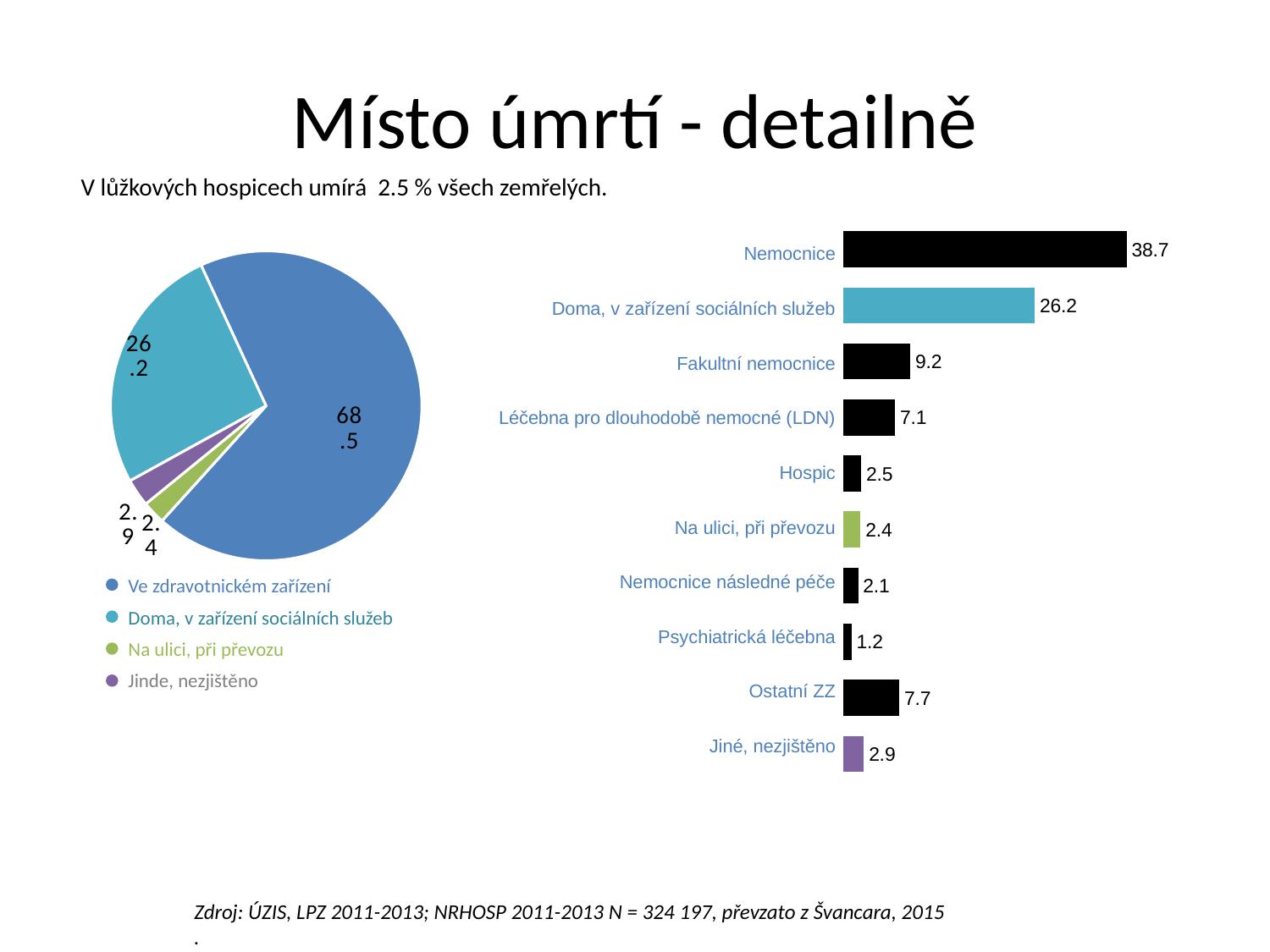
In the pie chart on the left, what is the value for Ve zdravotnickém zařízení? 68.5 In the pie chart on the left, which slice is the largest? Ve zdravotnickém zařízení In the bar chart on the right, what is the value for Nemocnice? 38.7 In the bar chart on the right, what is the value for Hospic? 2.5 How many categories does the bar chart on the right show? 10 In the bar chart on the right, which is larger: Fakultní nemocnice or Ostatní ZZ? Fakultní nemocnice How many entries does the legend of the pie chart on the left list? 4 In the bar chart on the right, what is the difference between the values for Nemocnice and Doma, v zařízení sociálních služeb? 12.5 In the bar chart on the right, which category has the highest value? Nemocnice In the bar chart on the right, which category has the lowest value? Psychiatrická léčebna In the bar chart on the right, what is the value for Ostatní ZZ? 7.7 What kind of chart is on the right side of the slide? bar chart